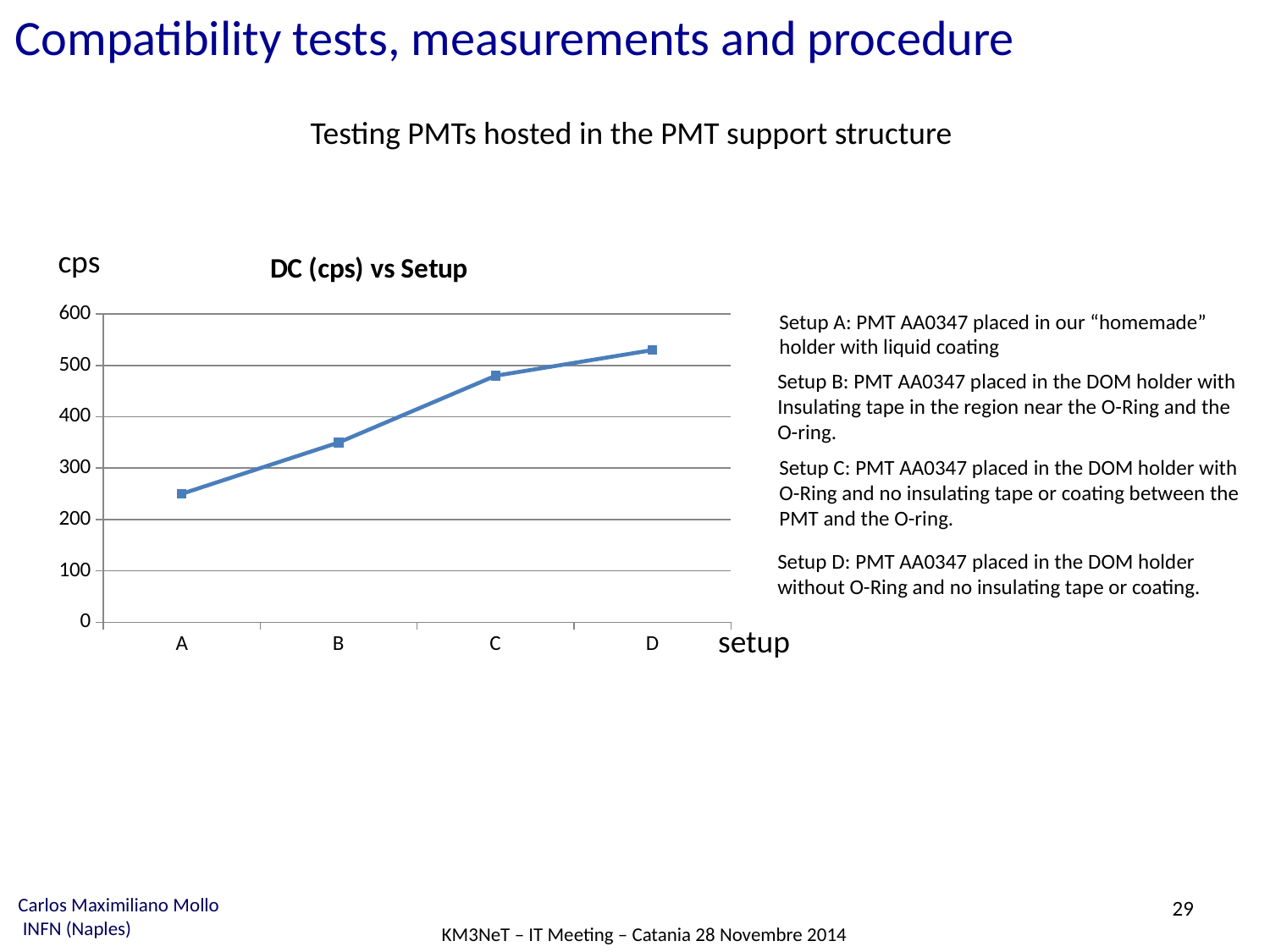
Is the value for setup B greater or less than 300? greater What is the title of the chart? DC (cps) vs Setup Is the value for setup C greater or less than 500? less Which has the larger DC value, setup B or setup C? C Which setup has the highest DC value? D Is the value for setup A greater or less than 200? greater How many setups are plotted on the x axis of the chart? 4 Do the DC values rise or fall from setup A to setup D? rise Which setup has the lowest DC value? A What kind of chart is shown on the slide? line chart